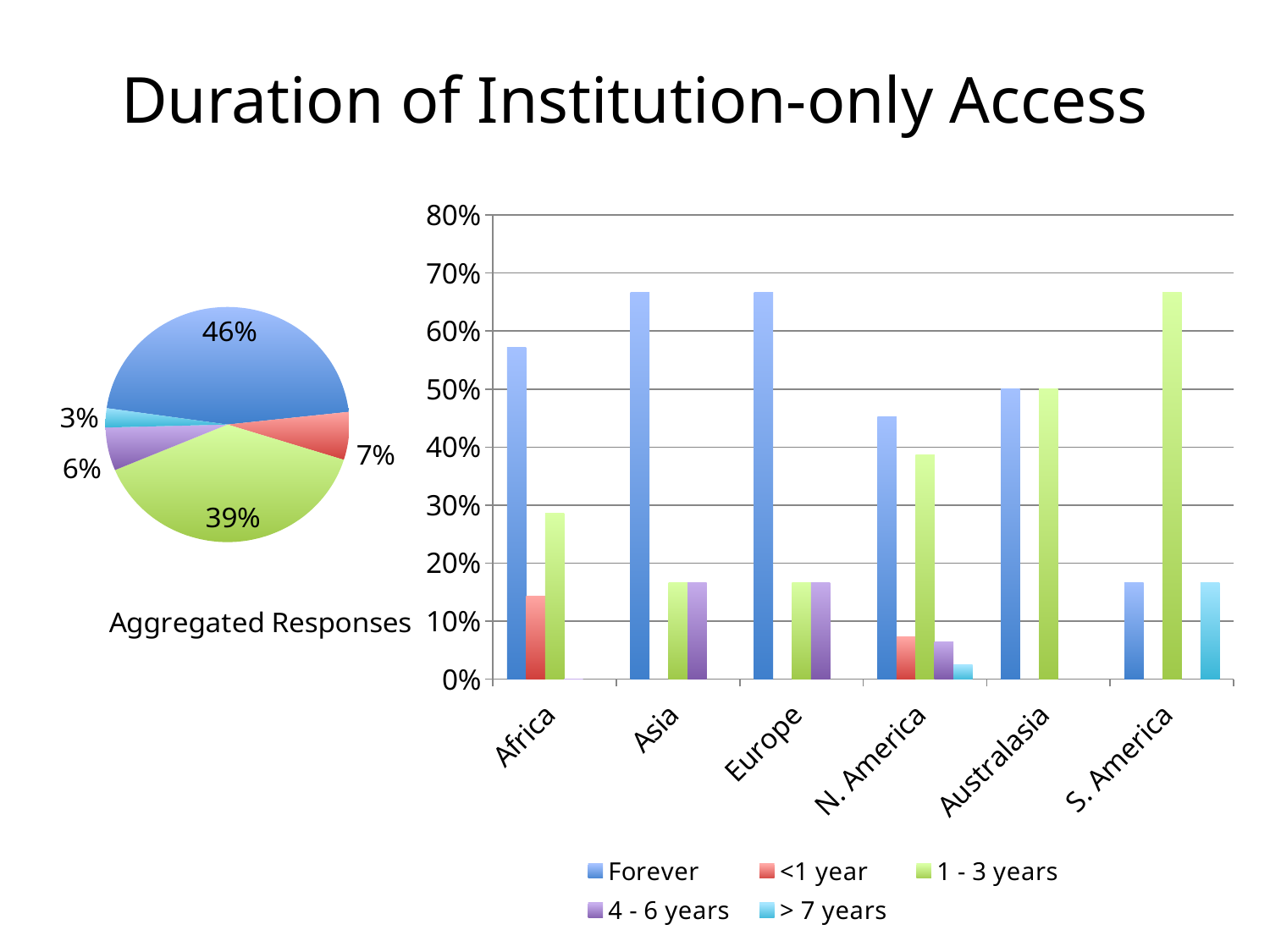
What kind of chart is the 'Aggregated Responses' chart on the left? pie chart In the 'Aggregated Responses' pie chart, what is the difference between the two largest slices (46% and 39%)? 7% In the bar chart, is the 'Forever' value for Asia greater or less than 60%? greater In the bar chart, is the 'Forever' value for N. America greater or less than 50%? less In the bar chart, which region has the highest '1 - 3 years' value? S. America How many series does the legend of the bar chart list? 5 In the 'Aggregated Responses' pie chart, what is the value of the largest slice? 46% In the bar chart, for Africa, which is larger: the 'Forever' value or the '1 - 3 years' value? Forever How many regions are shown on the x axis of the bar chart? 6 In the bar chart, which region has the lowest 'Forever' value? S. America What kind of chart is the chart on the right of the slide? bar chart In the 'Aggregated Responses' pie chart, what is the value of the smallest slice? 3%